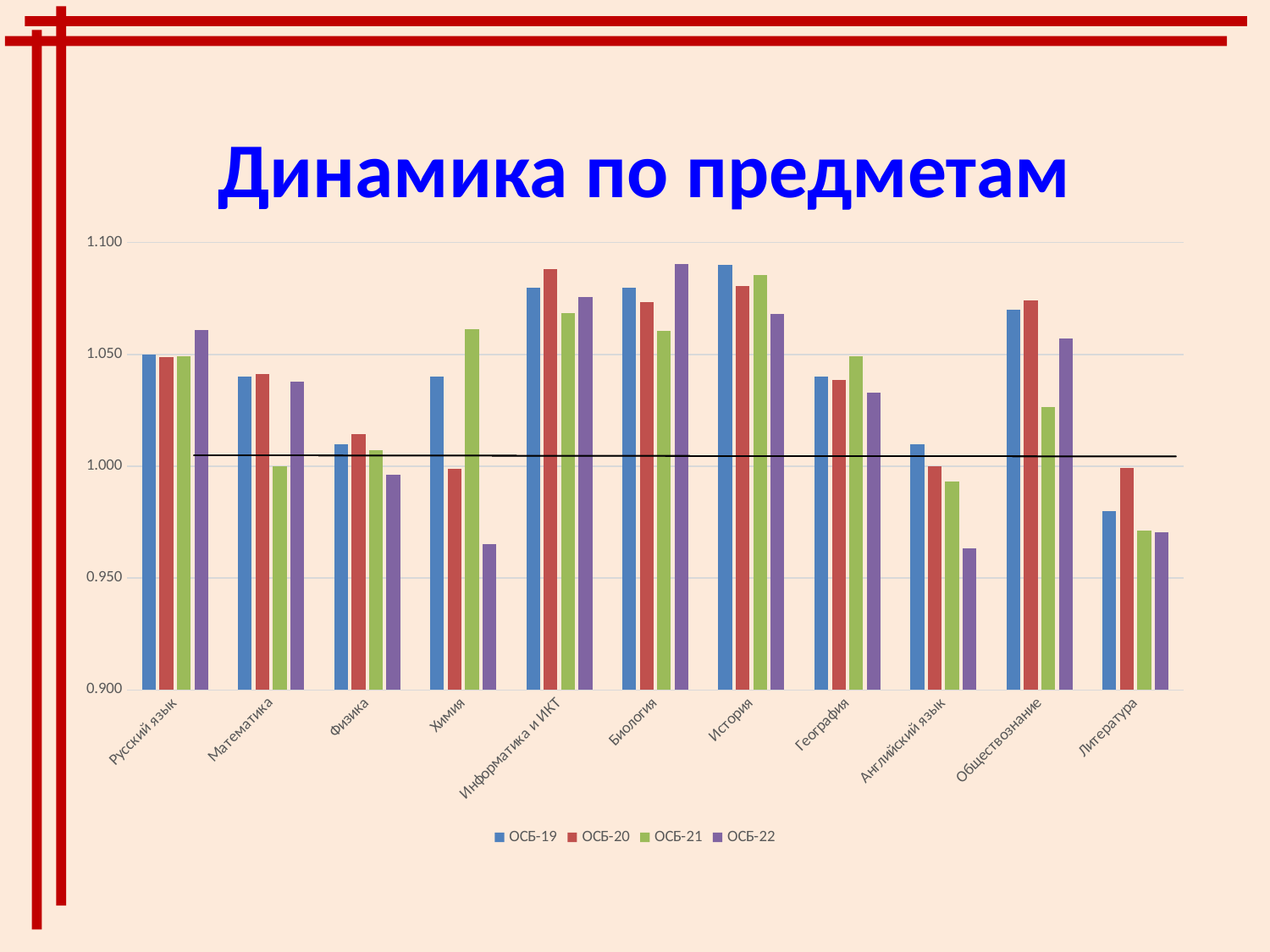
Which subject has the highest ОСБ-22 value? Биология Is the ОСБ-22 value for Русский язык greater or less than 1.050? greater How many series does the legend list? 4 What kind of chart is shown on the slide? bar chart Is the ОСБ-22 value for Химия greater or less than 1.000? less For Химия, which is larger: the ОСБ-21 value or the ОСБ-22 value? ОСБ-21 Which subject has the lowest ОСБ-19 value? Литература For Обществознание, which is larger: the ОСБ-20 value or the ОСБ-21 value? ОСБ-20 Is the ОСБ-19 value for История greater or less than 1.050? greater How many subject categories are shown on the x axis? 11 What is the title of the chart? Динамика по предметам